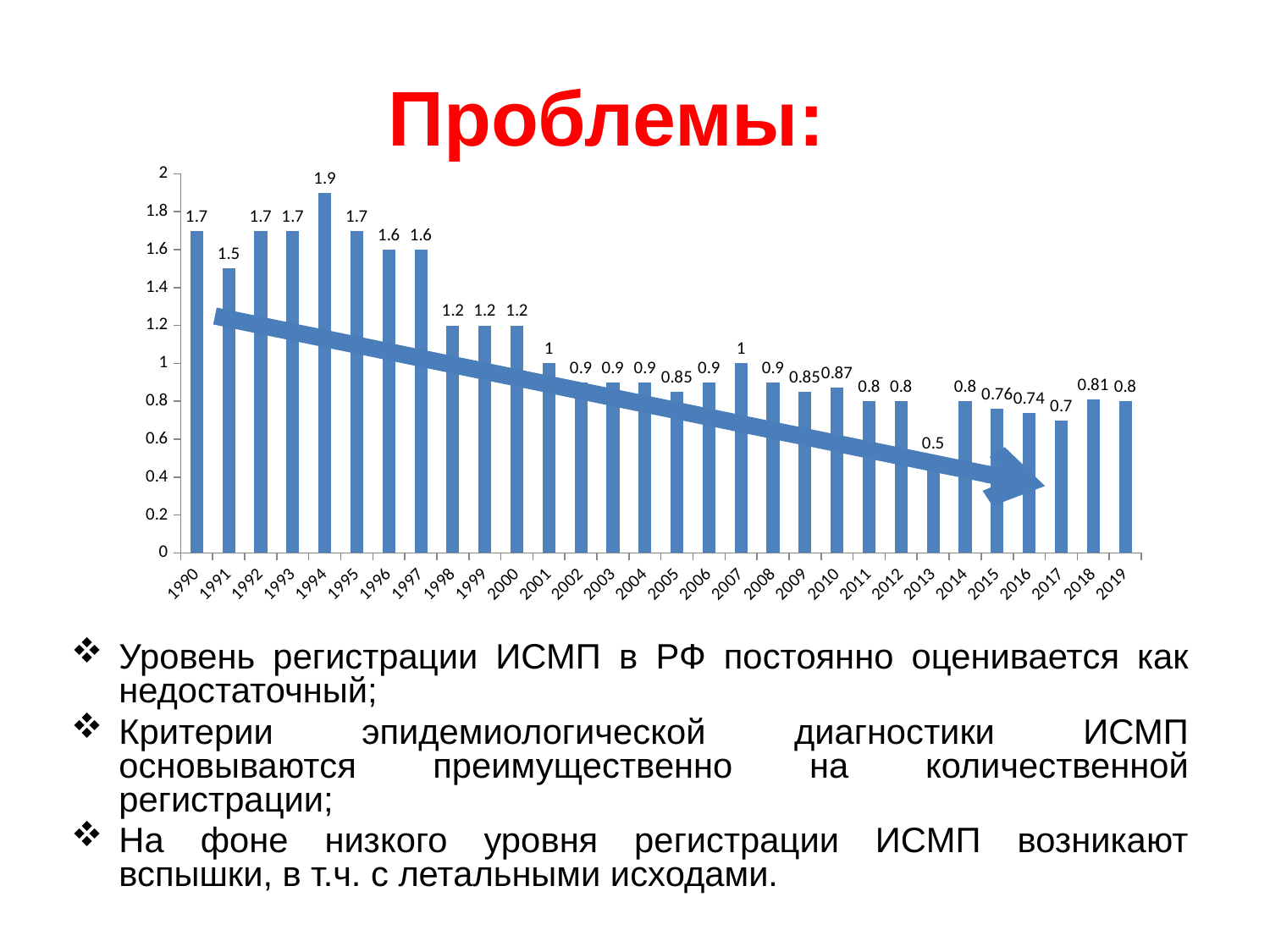
Which year has the lowest value? 2013 Which is larger, the value for 1991 or the value for 2001? 1991 What kind of chart is shown on the slide? bar chart What is the value for 2010? 0.87 What is the value for 1994? 1.9 How many years (bars) are shown on the chart? 30 What is the difference between the values for 1994 and 2013? 1.4 What is the value for 2013? 0.5 What is the value for 2016? 0.74 Which year has the highest value? 1994 Do the values generally rise or fall from 1990 to 2019? fall What is the difference between the values for 1990 and 2019? 0.9